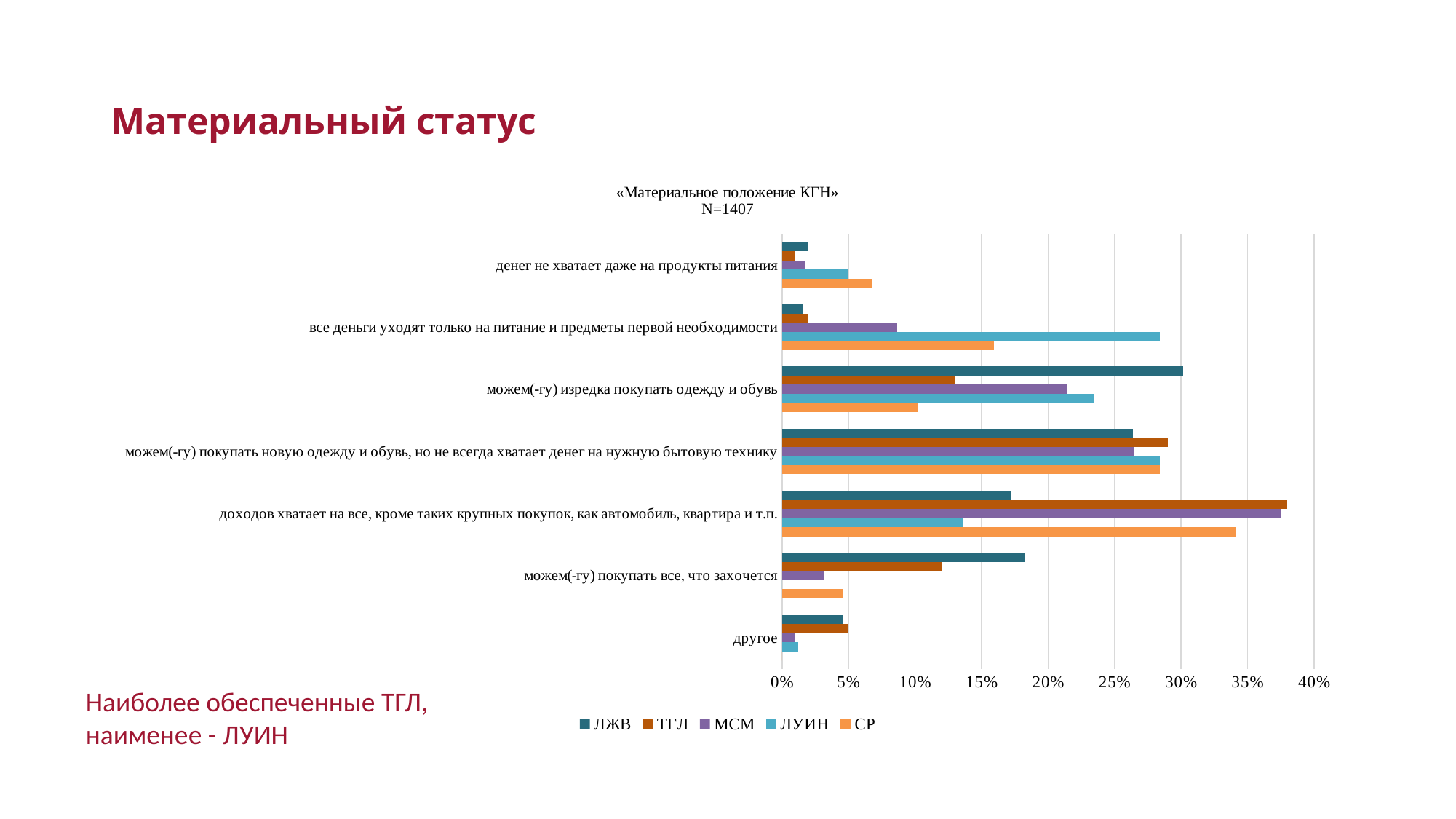
What sample size (N) is stated in the chart title? N=1407 Is the value for ТГЛ in the category «можем(-гу) изредка покупать одежду и обувь» greater or less than 15%? less Is the value for ЛУИН in the category «все деньги уходят только на питание и предметы первой необходимости» greater or less than 25%? greater Which series has the lowest value in the category «доходов хватает на все, кроме таких крупных покупок, как автомобиль, квартира и т.п.»? ЛУИН How many categories are plotted on the y axis? 7 In the category «можем(-гу) покупать все, что захочется», which is larger: ЛЖВ or ТГЛ? ЛЖВ Which series has the highest value in the category «можем(-гу) изредка покупать одежду и обувь»? ЛЖВ Is the value for СР in the category «доходов хватает на все, кроме таких крупных покупок, как автомобиль, квартира и т.п.» greater or less than 30%? greater How many series does the legend list? 5 Which series has the highest value in the category «все деньги уходят только на питание и предметы первой необходимости»? ЛУИН What kind of chart is shown on the slide? bar chart